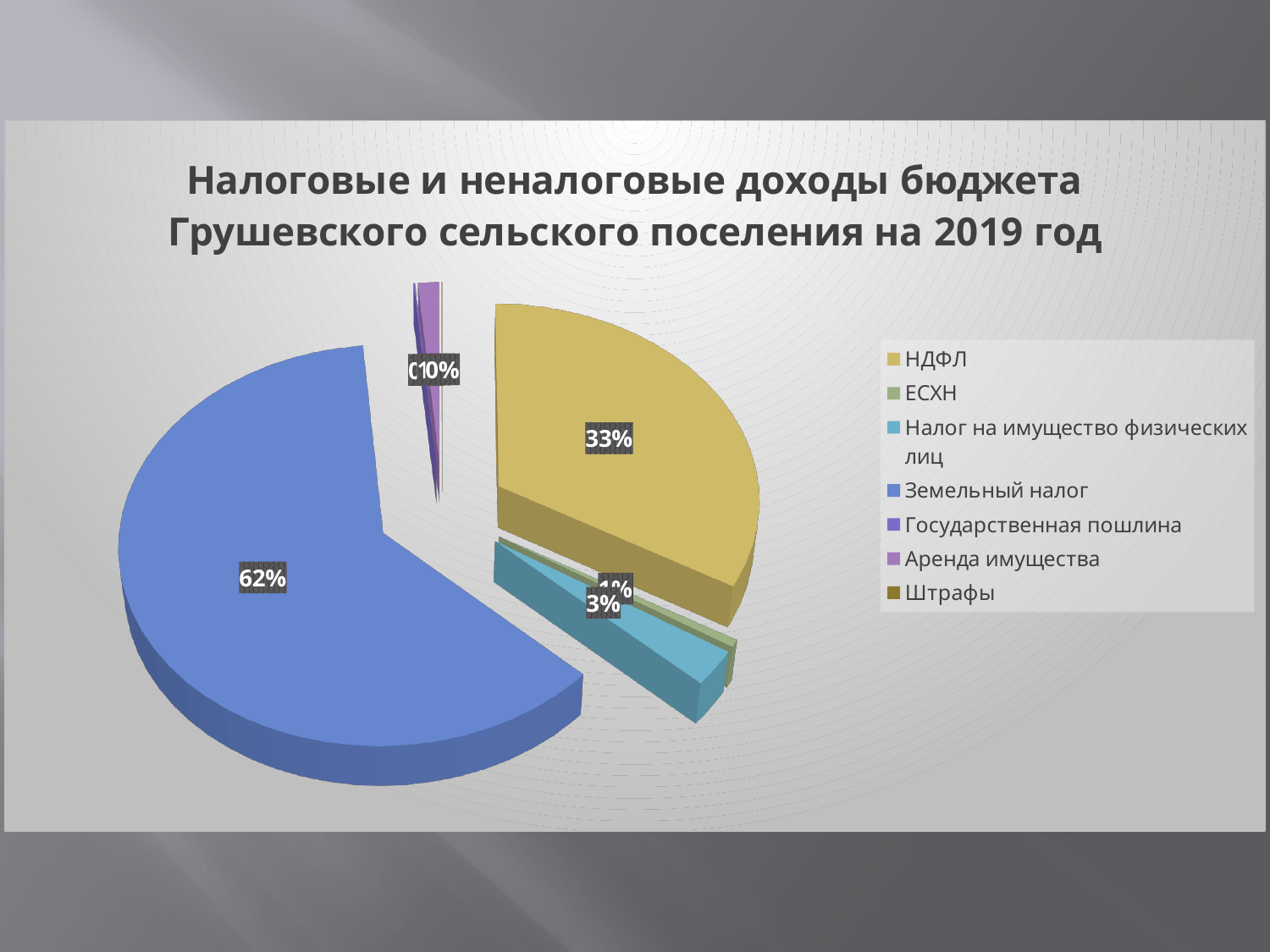
What is the title of the chart? Налоговые и неналоговые доходы бюджета Грушевского сельского поселения на 2019 год Which colour represents Земельный налог in the chart? blue Which revenue category has the largest share of the pie? Земельный налог What share of the budget revenue does НДФЛ account for? 33% Which is larger, the share for НДФЛ or the share for Налог на имущество физических лиц? НДФЛ What share of the budget revenue does Налог на имущество физических лиц account for? 3% What share of the budget revenue does Земельный налог account for? 62% By how many percentage points does the share of НДФЛ exceed the share of Налог на имущество физических лиц? 30 percentage points What kind of chart is shown on the slide? pie chart How many revenue categories are listed in the legend? 7 By how many percentage points does the share of Земельный налог exceed the share of НДФЛ? 29 percentage points Which is larger, the share for Земельный налог or the share for НДФЛ? Земельный налог